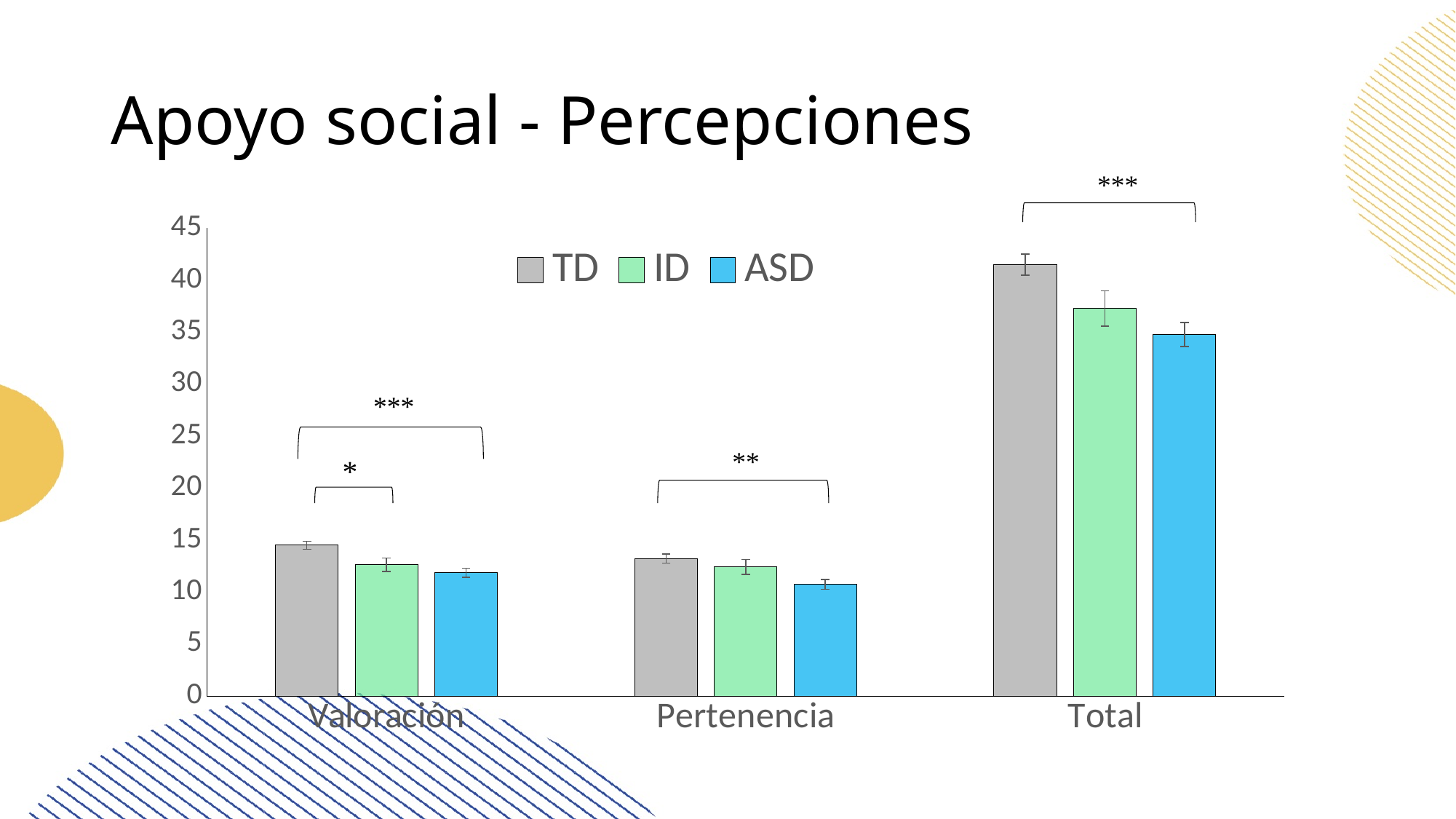
Which series has the lowest value in the Valoración category? ASD What kind of chart is shown on the slide? bar chart What are the three series names listed in the legend? TD, ID, ASD Which series has the lowest value in the Pertenencia category? ASD How many series does the legend list? 3 Is the value for ASD in the Total category greater or less than 30? greater Which series has the highest value in the Total category? TD Is the value for ID in the Total category greater or less than 40? less Is the value for TD in the Total category greater or less than 40? greater How many categories are shown on the x axis? 3 Which is larger: the TD value for Valoración or the TD value for Pertenencia? Valoración